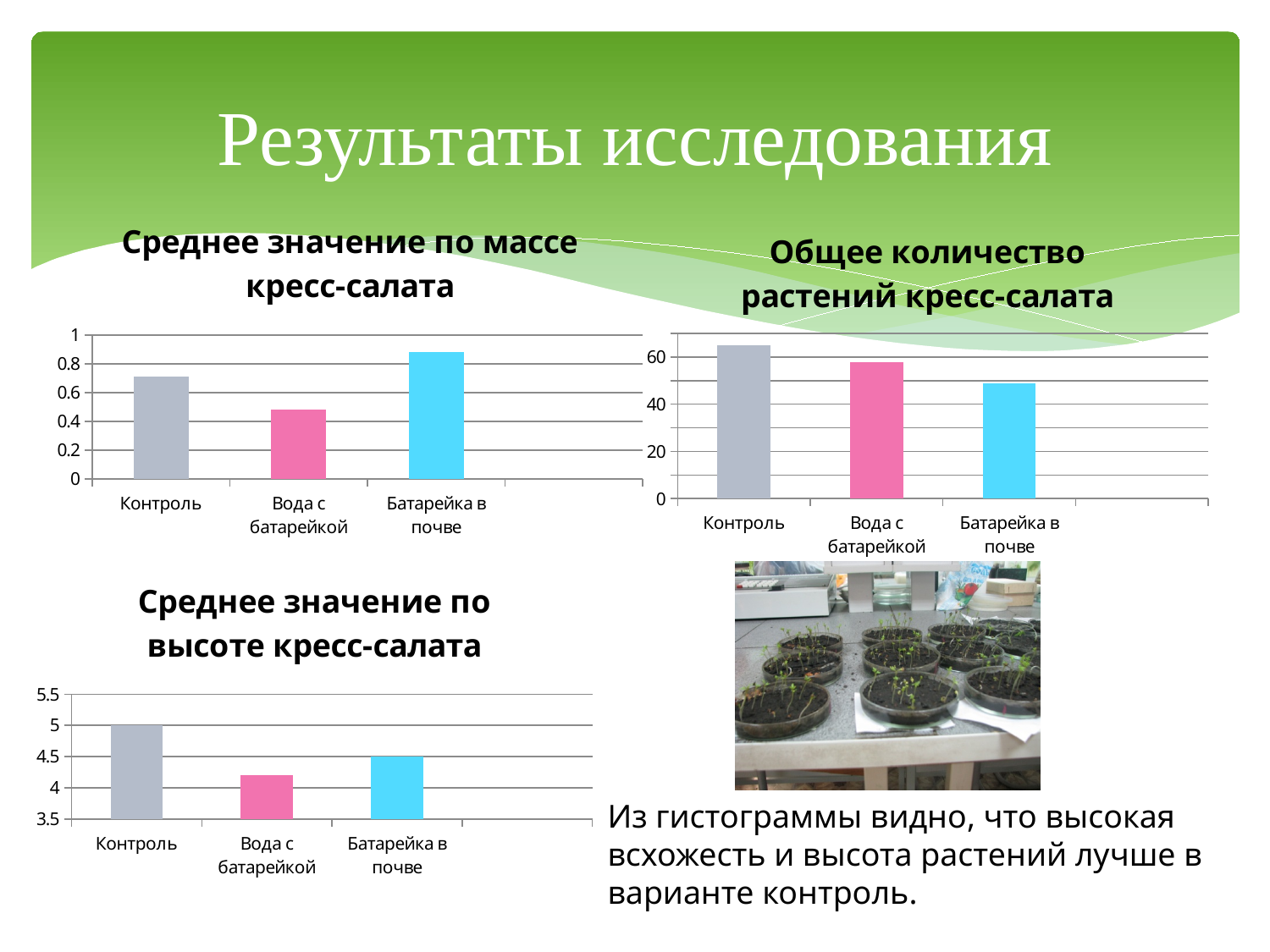
In the chart titled "Среднее значение по высоте кресс-салата", which is larger, the value for Контроль or the value for Вода с батарейкой? Контроль In the chart titled "Среднее значение по высоте кресс-салата", what is the difference between the values for Контроль and Батарейка в почве? 0.5 In the chart titled "Общее количество растений кресс-салата", how many categories are shown on the x axis? 3 In the chart titled "Общее количество растений кресс-салата", which category has the highest value? Контроль In the chart titled "Среднее значение по высоте кресс-салата", what is the value for Контроль? 5 In the chart titled "Общее количество растений кресс-салата", is the value for Контроль greater or less than 60? greater What kind of chart is the chart titled "Среднее значение по массе кресс-салата"? bar chart In the chart titled "Среднее значение по массе кресс-салата", which category has the lowest value? Вода с батарейкой In the chart titled "Среднее значение по массе кресс-салата", is the value for Вода с батарейкой greater or less than 0.6? less In the chart titled "Среднее значение по массе кресс-салата", which category has the highest value? Батарейка в почве In the chart titled "Среднее значение по высоте кресс-салата", what is the value for Батарейка в почве? 4.5 In the chart titled "Общее количество растений кресс-салата", which category has the lowest value? Батарейка в почве